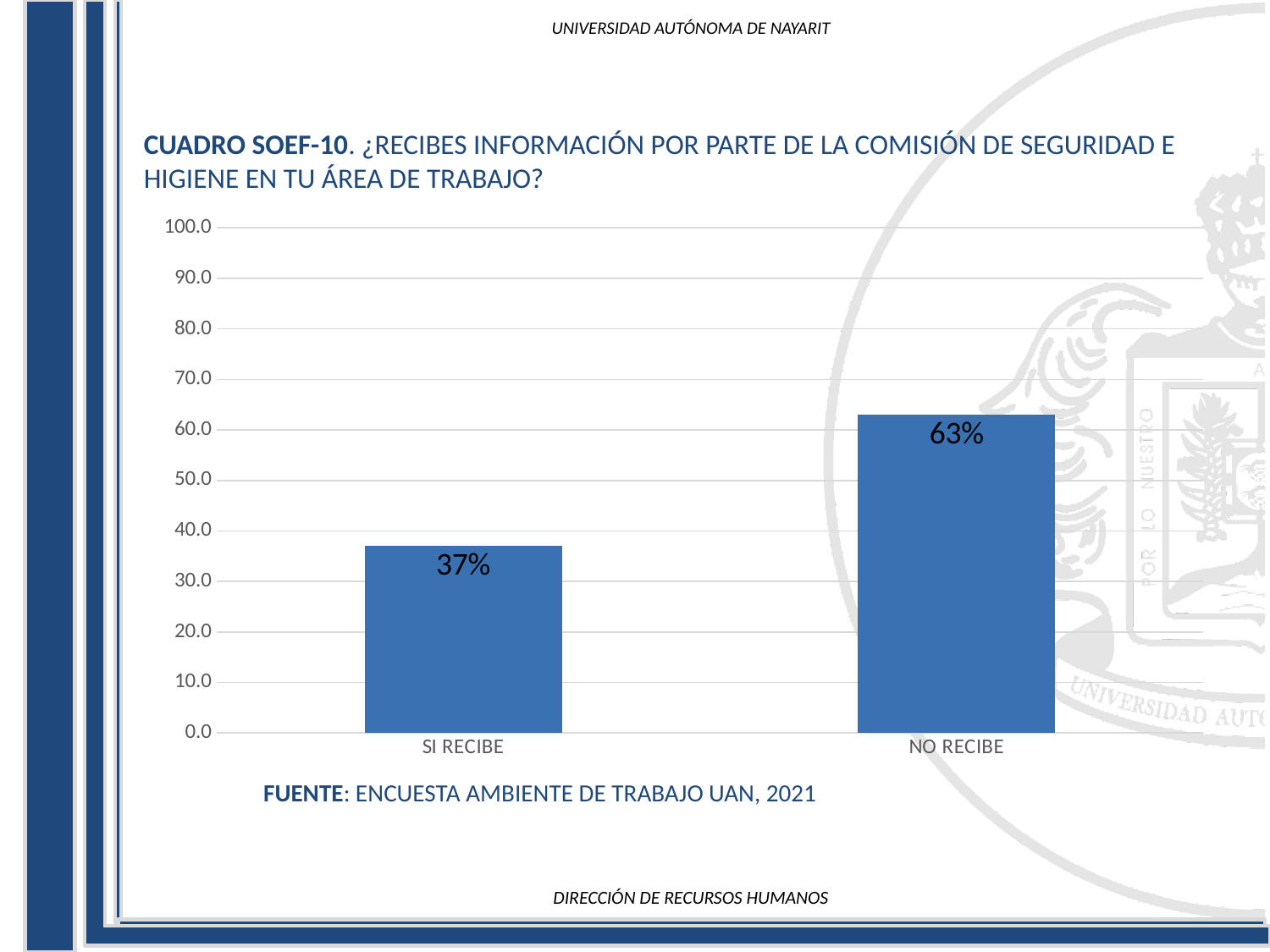
What is the value for SI RECIBE? 37% What is the value for NO RECIBE? 63% What kind of chart is shown on the slide? bar chart What is the maximum value shown on the y axis? 100.0 Which category has the lowest value? SI RECIBE How many categories are shown on the x axis? 2 Which is larger, the value for SI RECIBE or the value for NO RECIBE? NO RECIBE Is the value for SI RECIBE greater or less than 40.0? less Is the value for NO RECIBE greater or less than 60.0? greater What source is cited below the chart? ENCUESTA AMBIENTE DE TRABAJO UAN, 2021 What is the difference between the values for NO RECIBE and SI RECIBE? 26% Which category has the highest value? NO RECIBE